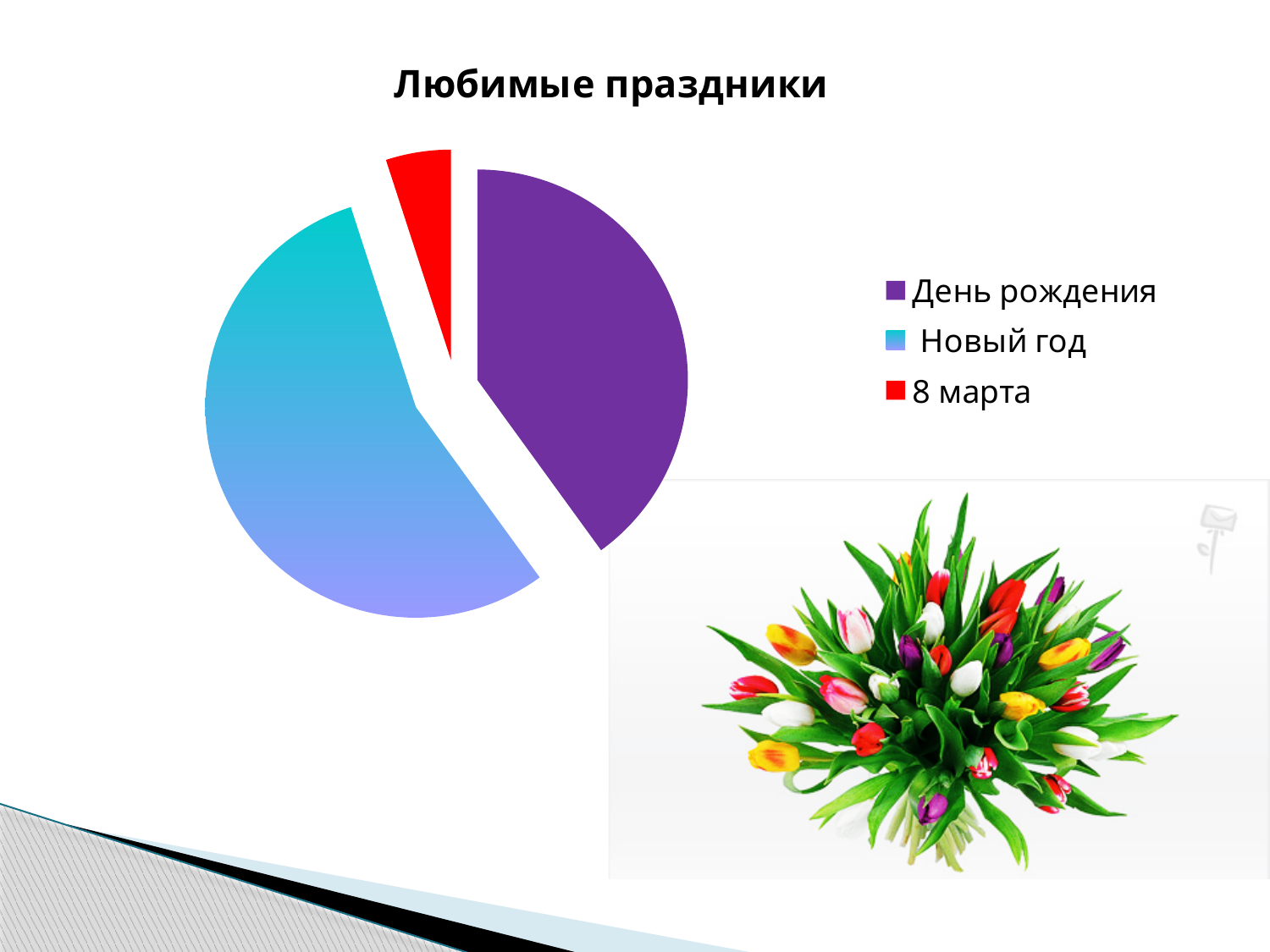
How many entries does the legend list? 3 Which category has the smallest slice of the pie? 8 марта Which slice is larger: День рождения or 8 марта? День рождения What is the title of the chart? Любимые праздники How many slices does the pie chart have? 3 What kind of chart is shown on the slide? pie chart Which category has the largest slice of the pie? Новый год Which slice is larger: Новый год or 8 марта? Новый год What colour is the slice for 8 марта? red